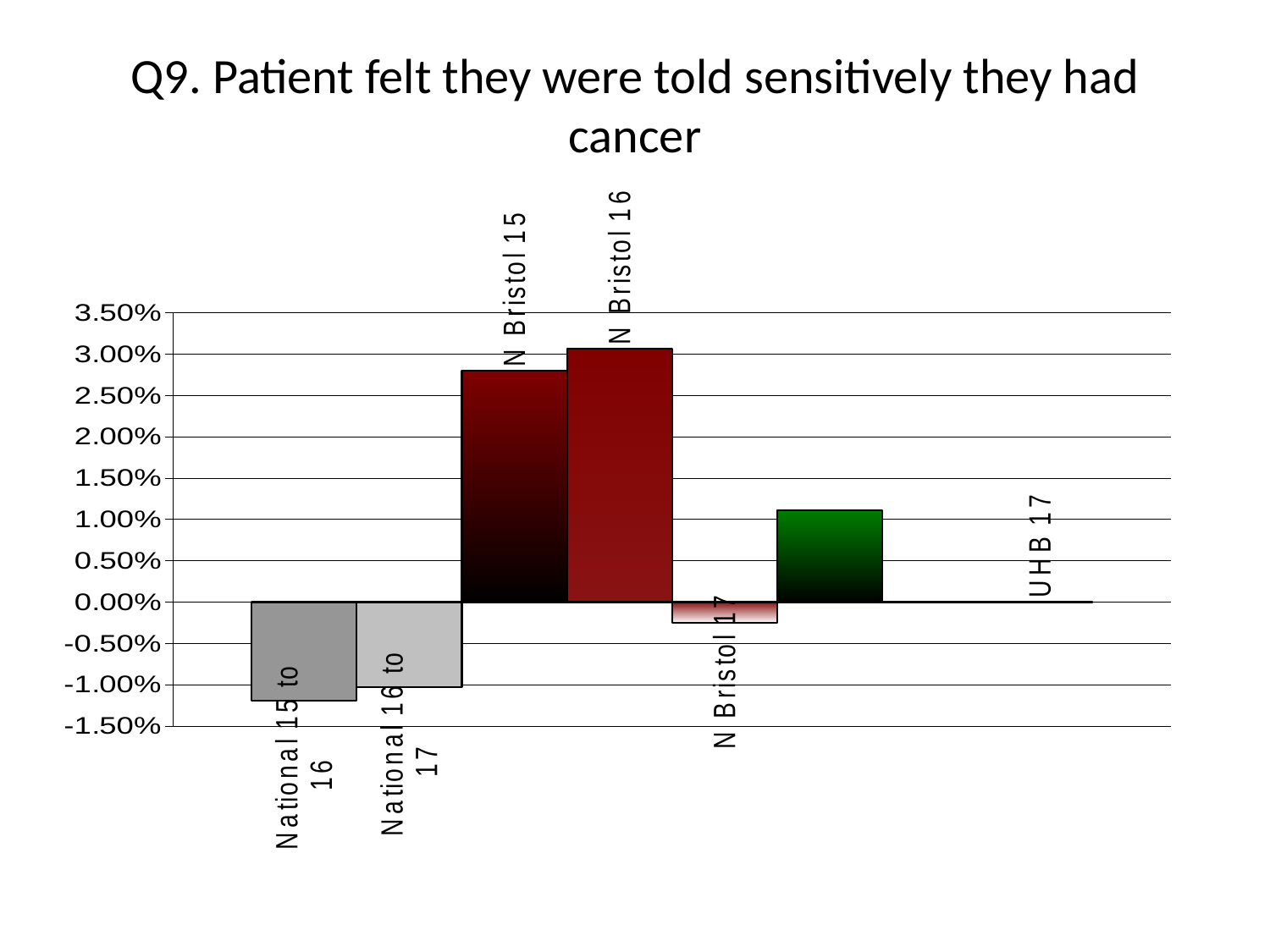
Is the value for N Bristol 16 greater or less than 2.50%? greater What is the highest value shown on the vertical axis? 3.50% Is the value for National 16 to 17 greater or less than -0.50%? less Is the value for N Bristol 17 greater or less than -0.50%? greater Which is larger, the value for National 15 to 16 or N Bristol 15? N Bristol 15 What kind of chart is shown on the slide? bar chart Which category has the lowest value? National 15 to 16 What is the title of the chart? Q9. Patient felt they were told sensitively they had cancer Which category has the highest value? N Bristol 16 Which is larger, the value for N Bristol 15 or N Bristol 16? N Bristol 16